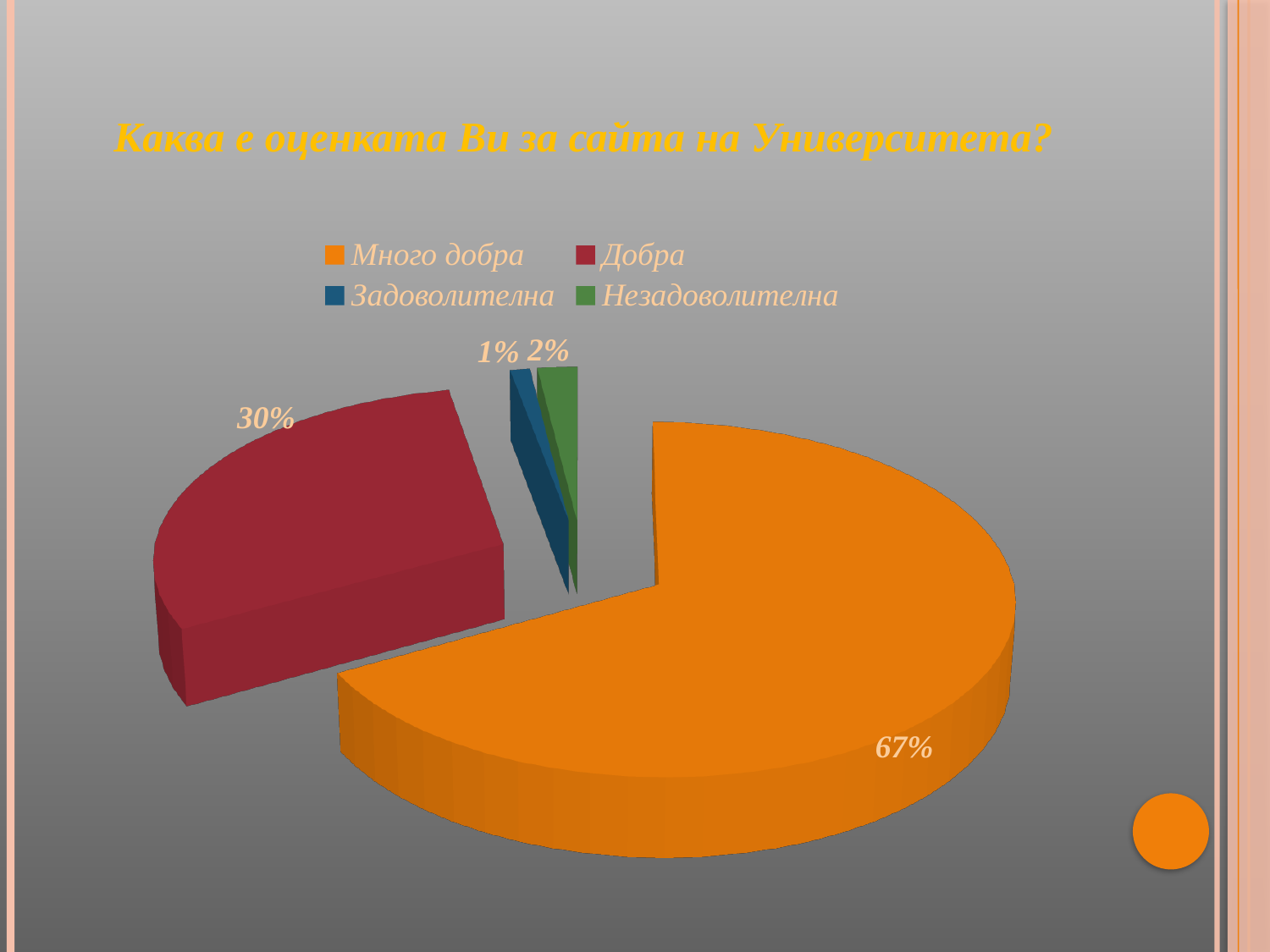
Which is larger, the share for "Добра" or the share for "Незадоволителна"? Добра What is the difference between the shares of "Много добра" and "Добра"? 37% Which category has the smallest slice of the pie? Задоволителна What share of the pie does "Добра" have? 30% Which category has the largest slice of the pie? Много добра What share of the pie does "Незадоволителна" have? 2% What share of the pie does "Задоволителна" have? 1% What kind of chart is shown on the slide? pie chart What colour is the slice for "Добра"? red How many categories does the pie chart have? 4 What is the title of the chart? Каква е оценката Ви за сайта на Университета?